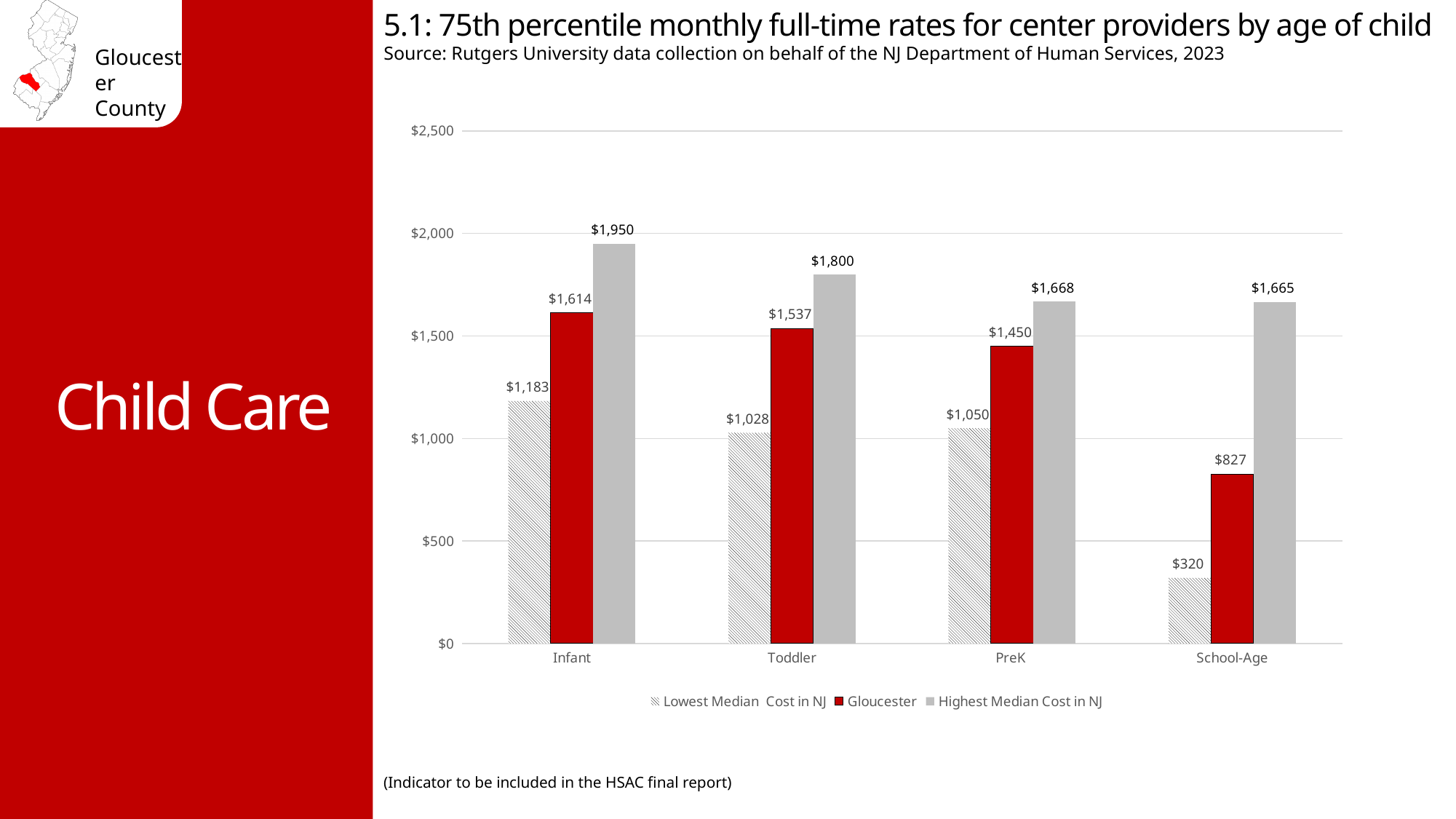
What is the Highest Median Cost in NJ for Toddler? $1,800 How many age groups are shown on the x axis? 4 How many series does the legend list? 3 What is the Gloucester value for Infant? $1,614 Is the Gloucester value for School-Age greater or less than $1,000? less Do the Gloucester values rise or fall from Infant to School-Age? Fall Which age group has the highest Gloucester value? Infant What is the Lowest Median Cost in NJ for School-Age? $320 What kind of chart is shown on the slide? Bar chart Which is larger for Toddler: the Gloucester value or the Lowest Median Cost in NJ? Gloucester What is the difference between the Highest Median Cost in NJ and the Gloucester value for PreK? $218 Which age group has the lowest Lowest Median Cost in NJ value? School-Age